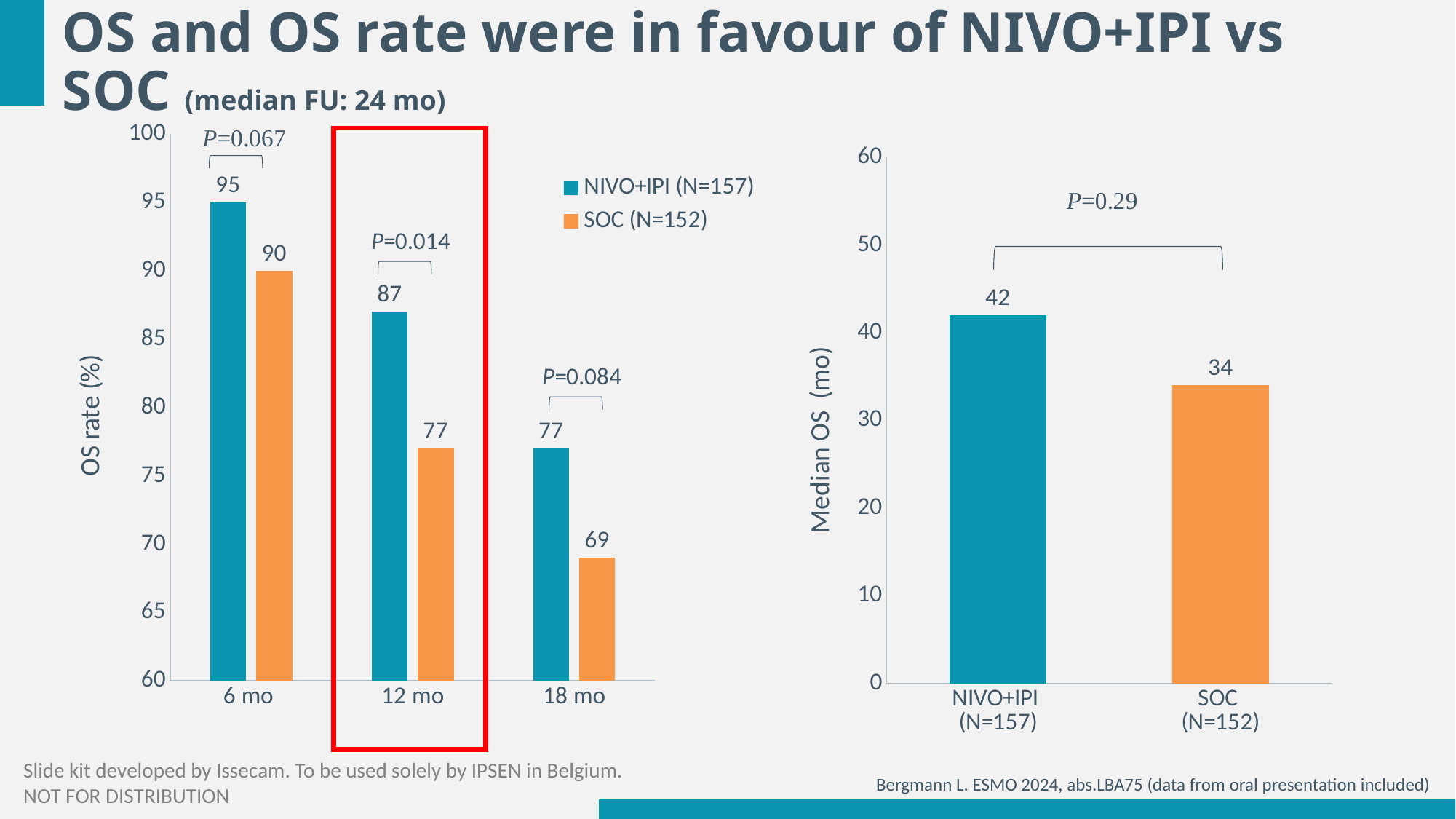
In the left chart (OS rate), which time point has the lowest SOC value? 18 mo In the left chart (OS rate), what is the difference between NIVO+IPI and SOC at 12 mo? 10 In the left chart (OS rate), does the NIVO+IPI OS rate rise or fall from 6 mo to 18 mo? fall In the right chart (Median OS), which group has the higher median OS? NIVO+IPI (N=157) What kind of chart is the right chart (Median OS)? bar chart In the left chart (OS rate), how many time points are shown on the x axis? 3 In the left chart (OS rate), what is the OS rate for SOC at 6 mo? 90 In the right chart (Median OS), what is the median OS for NIVO+IPI (N=157)? 42 In the left chart (OS rate), how many series does the legend list? 2 In the left chart (OS rate), what is the OS rate for NIVO+IPI at 12 mo? 87 In the left chart (OS rate), what is the OS rate for SOC at 18 mo? 69 In the right chart (Median OS), what is the difference in median OS between NIVO+IPI and SOC? 8